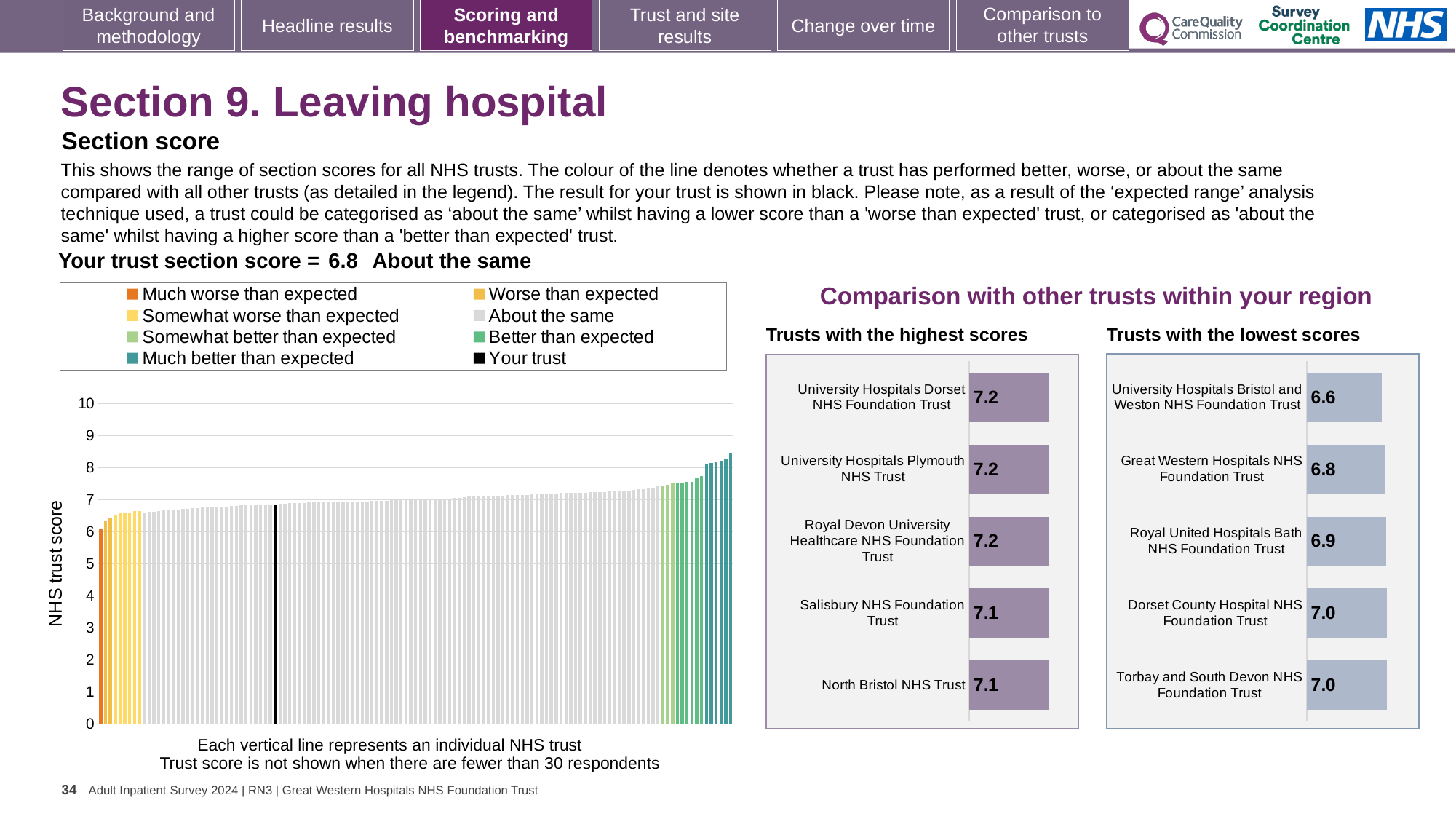
What kind of chart is the large chart on the left showing NHS trust scores? Bar chart How many trusts are shown in the 'Trusts with the highest scores' chart? 5 In the 'Trusts with the lowest scores' chart, which trust has the lowest score? University Hospitals Bristol and Weston NHS Foundation Trust In the large chart on the left, do the NHS trust scores rise or fall from left to right? Rise How many entries does the legend of the large chart on the left list? 8 In the 'Trusts with the lowest scores' chart, which has the higher score: Great Western Hospitals NHS Foundation Trust or Dorset County Hospital NHS Foundation Trust? Dorset County Hospital NHS Foundation Trust What is your trust's section score for Section 9, Leaving hospital? 6.8 In the large chart on the left, is the value of the tallest bar greater or less than 8? greater In the 'Trusts with the highest scores' chart, what is the difference between the scores of University Hospitals Dorset NHS Foundation Trust and North Bristol NHS Trust? 0.1 In the 'Trusts with the highest scores' chart, what is the score for Salisbury NHS Foundation Trust? 7.1 In the 'Trusts with the lowest scores' chart, what is the score for Royal United Hospitals Bath NHS Foundation Trust? 6.9 In the 'Trusts with the lowest scores' chart, what is the difference between the scores of Torbay and South Devon NHS Foundation Trust and University Hospitals Bristol and Weston NHS Foundation Trust? 0.4